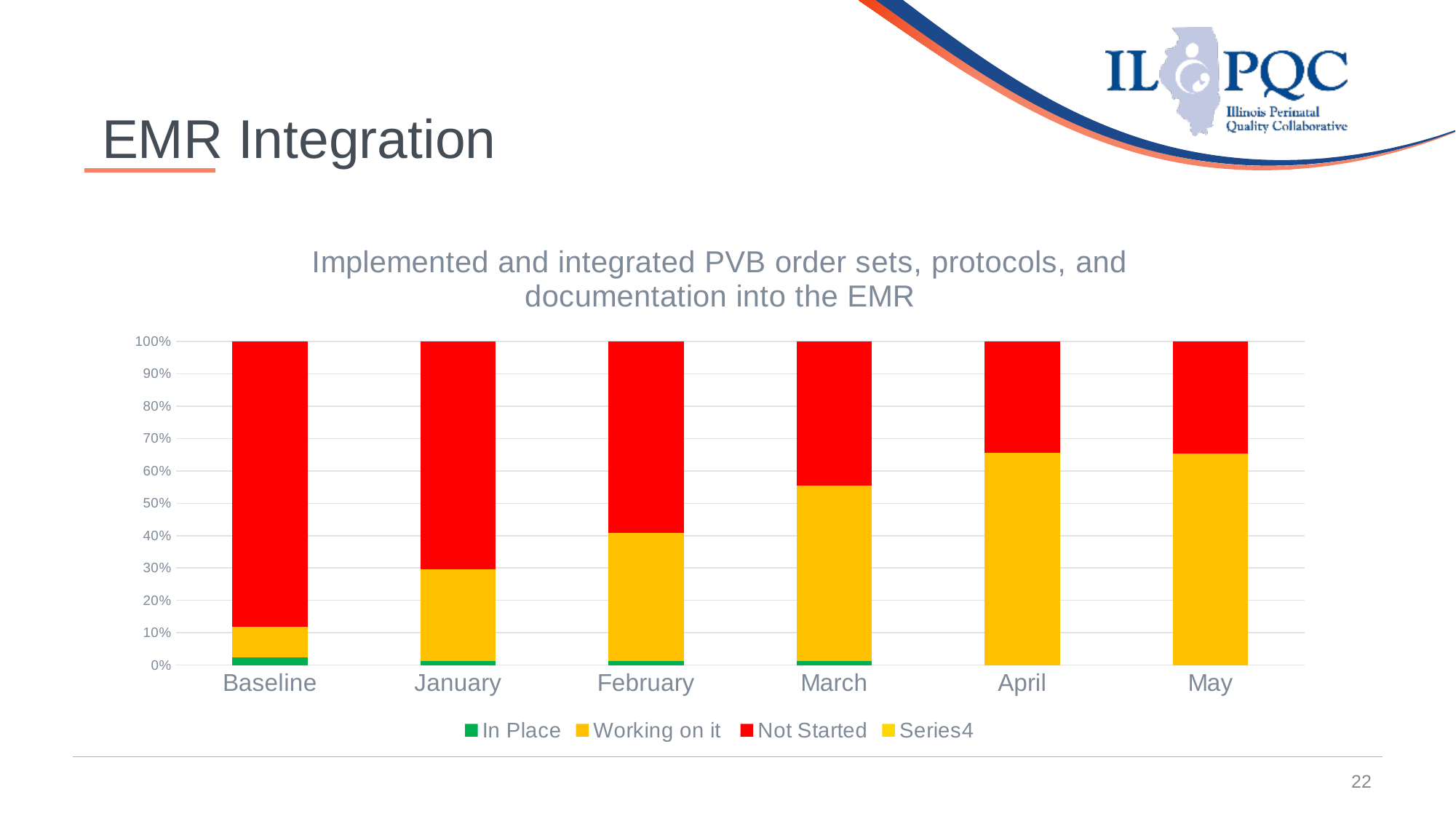
Which category has the largest 'Not Started' share? Baseline Is the 'Working on it' value for April greater or less than 60%? greater Is the 'Not Started' value for May greater or less than 40%? less Is the 'Not Started' value for Baseline greater or less than 80%? greater How many series does the chart's legend list? 4 Does the 'Not Started' share rise or fall from Baseline to May? Fall How many categories are shown along the x axis of the chart? 6 Is the 'Working on it' share larger in April or in Baseline? April Which colour represents 'Not Started' in the chart? Red What kind of chart is shown on the slide? Stacked bar chart Which category has the smallest 'Working on it' share? Baseline